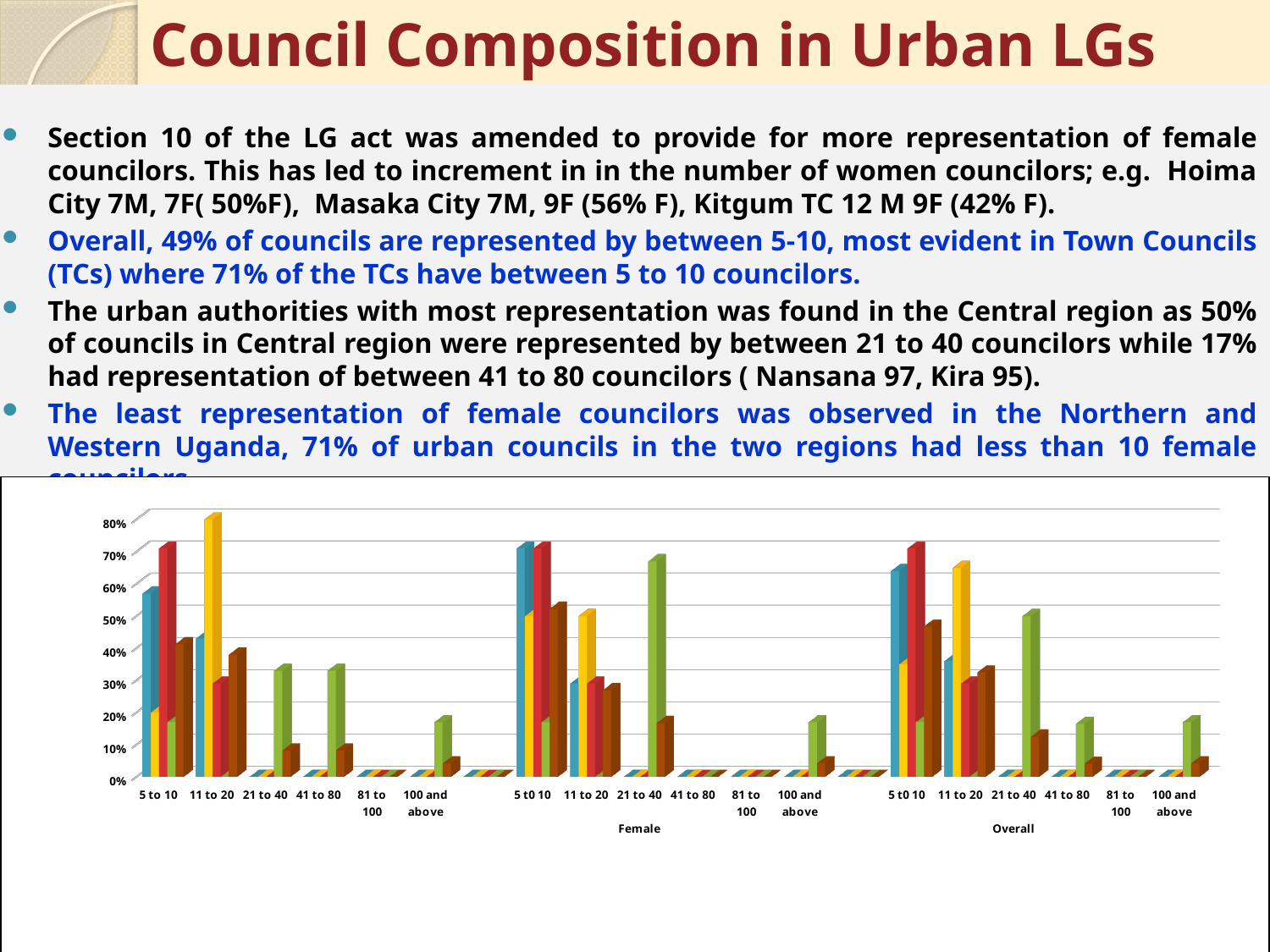
In the Female group, is the green bar for 21 to 40 greater or less than 50%? greater In the Overall group, which is larger: the blue bar for 5 to 10 or the blue bar for 11 to 20? 5 to 10 In the leftmost group, is the yellow bar for 11 to 20 greater or less than 70%? greater In the Female group, is the blue bar for 11 to 20 greater or less than 40%? less In the Female group, do the green bars rise or fall from 21 to 40 to 41 to 80? fall Which two group labels are readable beneath the category axis of the chart? Female and Overall What is the highest value shown on the vertical axis of the chart? 80% What kind of chart is shown on the slide? bar chart How many councillor-count categories are shown within the Female group of the chart? 6